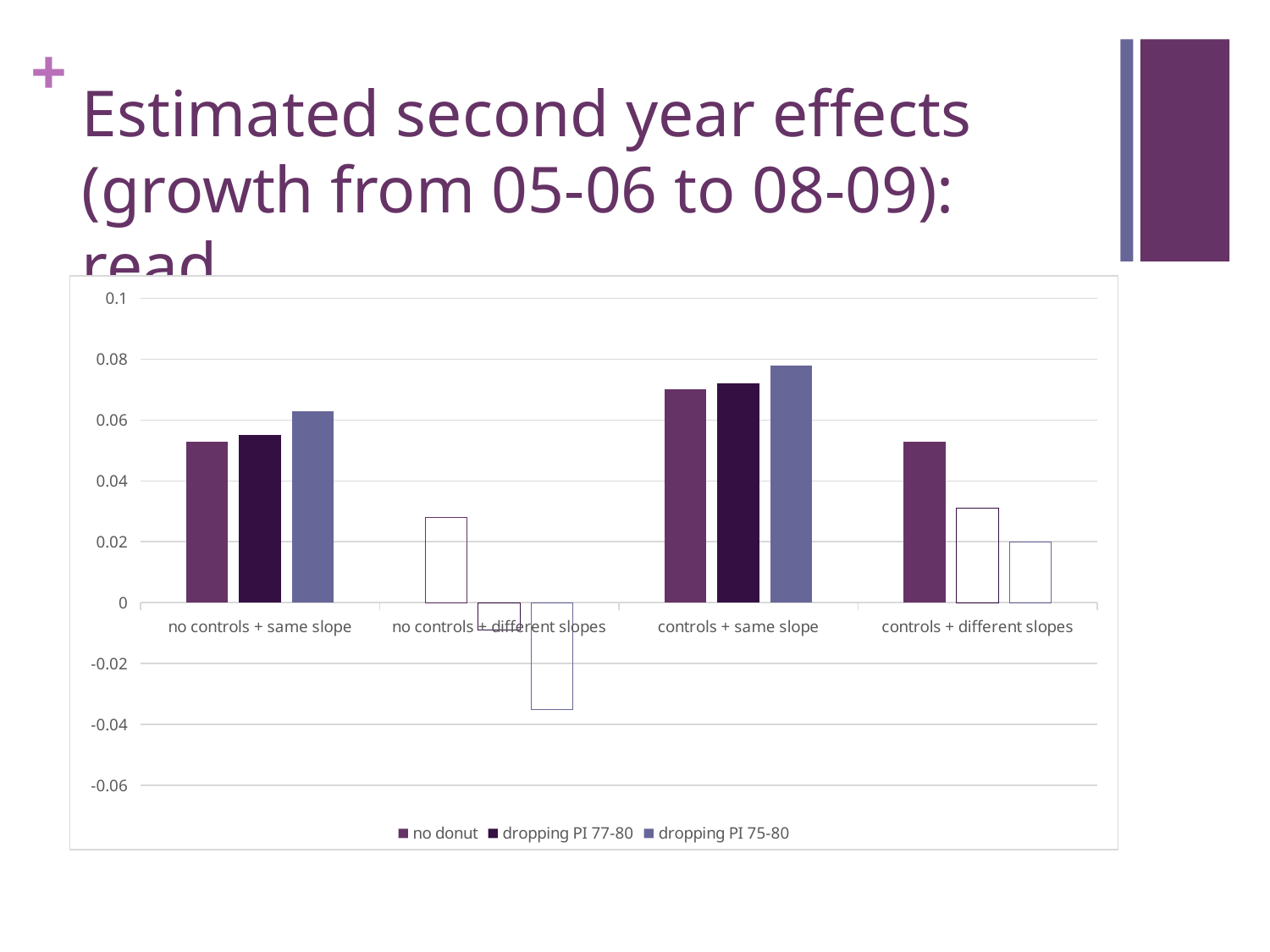
Is the value of 'dropping PI 77-80' for 'controls + different slopes' greater or less than 0.04? less Which series does the chart's legend list first? no donut How many series does the chart's legend list? 3 What kind of chart is shown on the slide? bar chart For the 'no donut' series, which is larger: the value for 'controls + same slope' or for 'no controls + same slope'? controls + same slope How many categories are shown on the x axis of the chart? 4 Which category has the lowest value for the 'dropping PI 75-80' series? no controls + different slopes For 'controls + different slopes', which is larger: the 'no donut' value or the 'dropping PI 75-80' value? no donut Is the value of 'no donut' for 'no controls + same slope' greater or less than 0.04? greater Which category has the highest value for the 'dropping PI 75-80' series? controls + same slope Is the value of 'dropping PI 75-80' for 'controls + same slope' greater or less than 0.06? greater